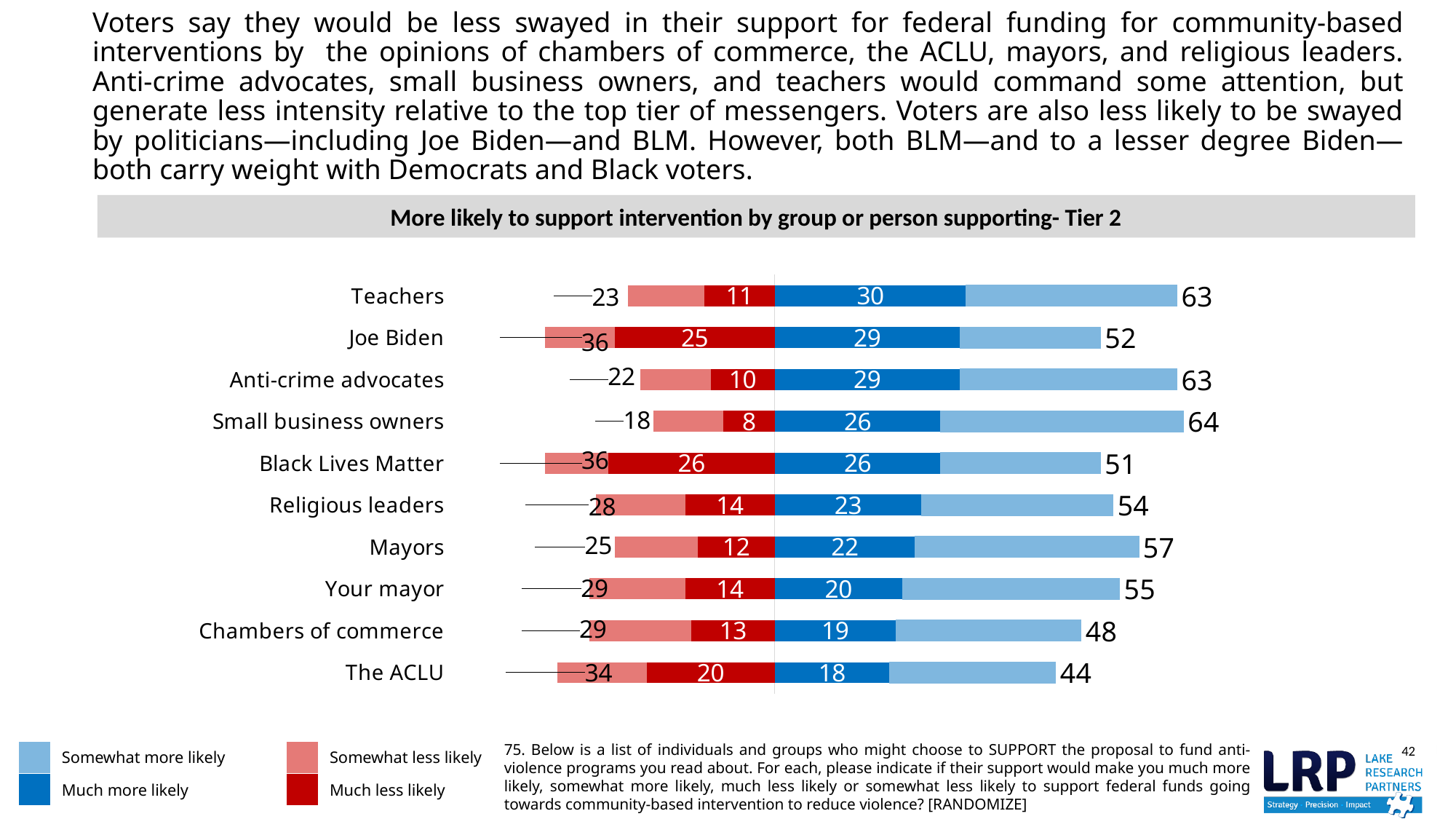
How many series does the legend list? 4 Which group has the highest total 'more likely' value? Small business owners What is the 'Much less likely' value for Black Lives Matter? 26 Which has a larger 'Much more likely' value, Mayors or Your mayor? Mayors What is the 'Much more likely' value for Teachers? 30 What is the total 'less likely' value shown for Joe Biden? 36 What is the title of the chart? More likely to support intervention by group or person supporting- Tier 2 Which group has the lowest total 'more likely' value? The ACLU How many groups or persons are listed in the chart? 10 What is the total 'more likely' value shown for Small business owners? 64 What is the difference between the total 'more likely' values for Teachers and The ACLU? 19 What kind of chart is shown on the slide? Stacked bar chart